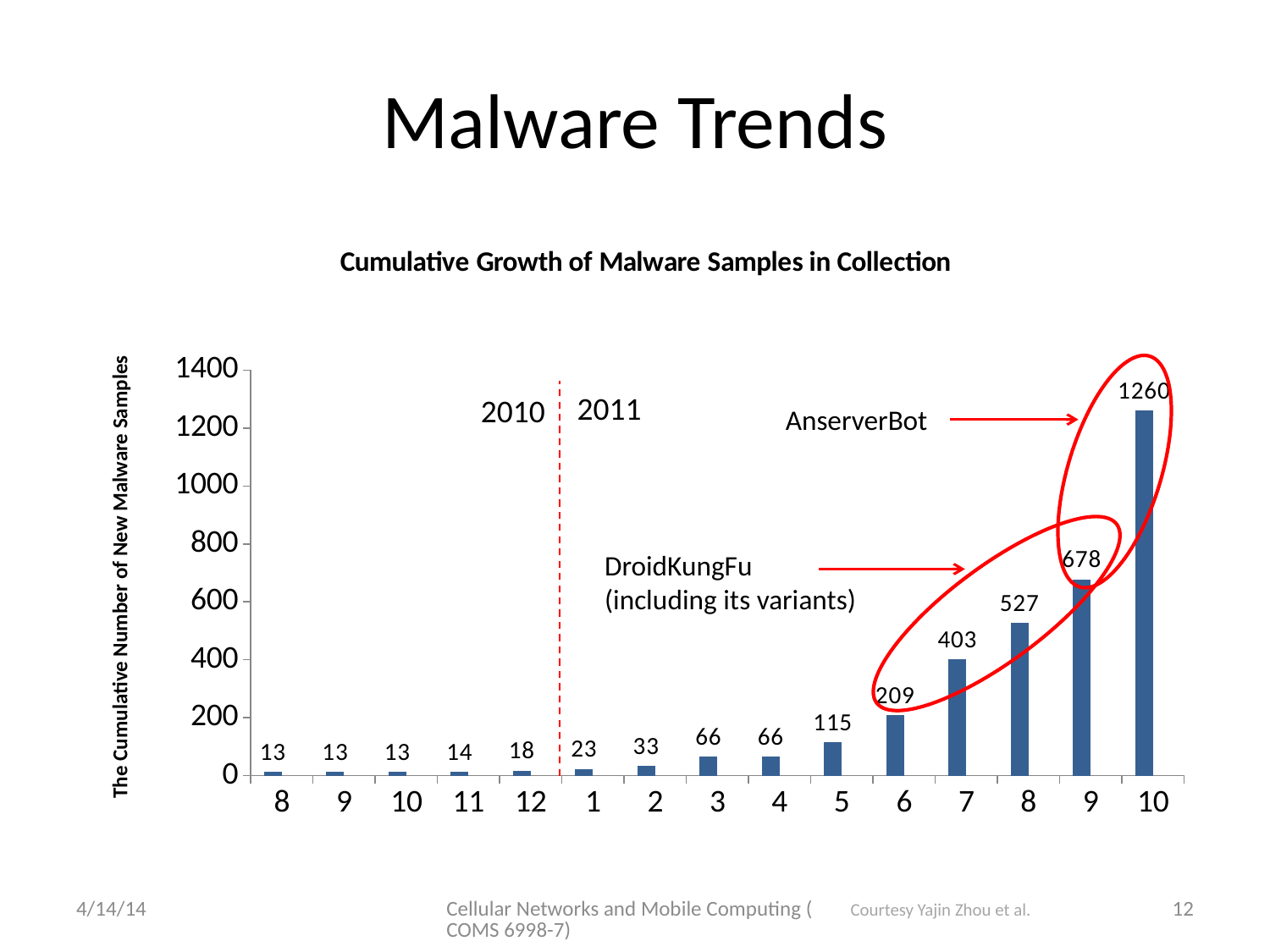
What is the cumulative number of new malware samples in month 10 of 2011? 1260 What is the difference between the values for month 9 of 2011 and month 8 of 2011? 151 Do the values rise or fall from left to right along the x axis? Rise What kind of chart is shown on the slide? Bar chart What is the title of the chart? Cumulative Growth of Malware Samples in Collection Which is larger, the value for month 7 of 2011 or the value for month 5 of 2011? Month 7 of 2011 Is the value for month 8 of 2011 greater or less than 400? greater What is the cumulative number of new malware samples in month 6 of 2011? 209 How many bars are plotted in the chart? 15 Which month has the highest cumulative number of new malware samples? 10 (2011) What is the cumulative number of new malware samples in month 12 of 2010? 18 What is the difference between the values for month 10 of 2011 and month 9 of 2011? 582